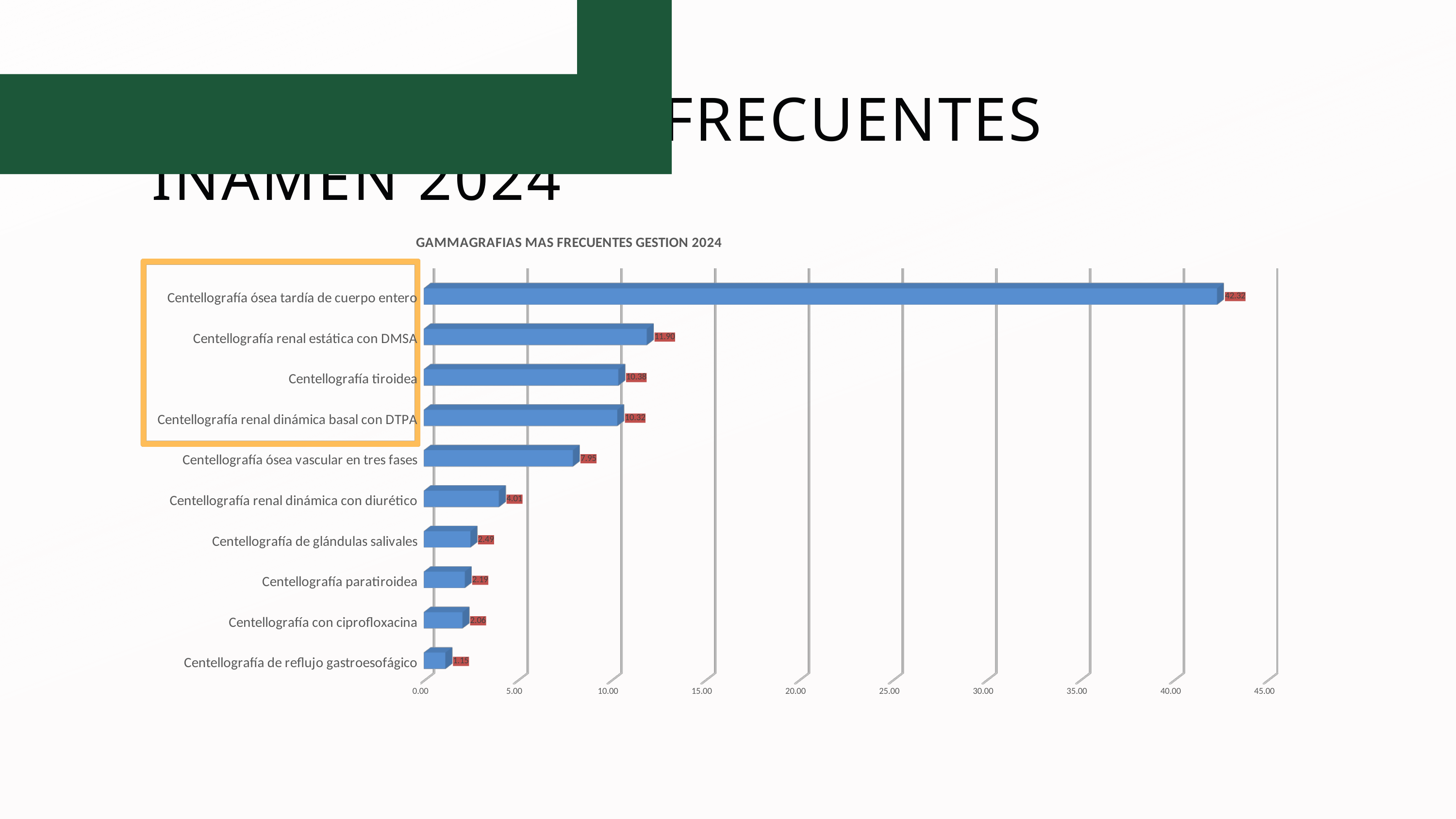
What is the value for Centellografía ósea tardía de cuerpo entero? 42.32 Which is larger, the value for Centellografía tiroidea or Centellografía ósea vascular en tres fases? Centellografía tiroidea Which category has the highest value? Centellografía ósea tardía de cuerpo entero What kind of chart is shown on the slide? bar chart Which category has the lowest value? Centellografía de reflujo gastroesofágico What is the value for Centellografía de reflujo gastroesofágico? 1.15 What is the value for Centellografía renal estática con DMSA? 11.90 What is the difference between the values for Centellografía ósea tardía de cuerpo entero and Centellografía renal estática con DMSA? 30.42 What is the value for Centellografía ósea vascular en tres fases? 7.95 How many categories are shown in the chart? 10 What is the title of the chart? GAMMAGRAFIAS MAS FRECUENTES GESTION 2024 Is the value for Centellografía renal dinámica con diurético greater or less than 5.00? less